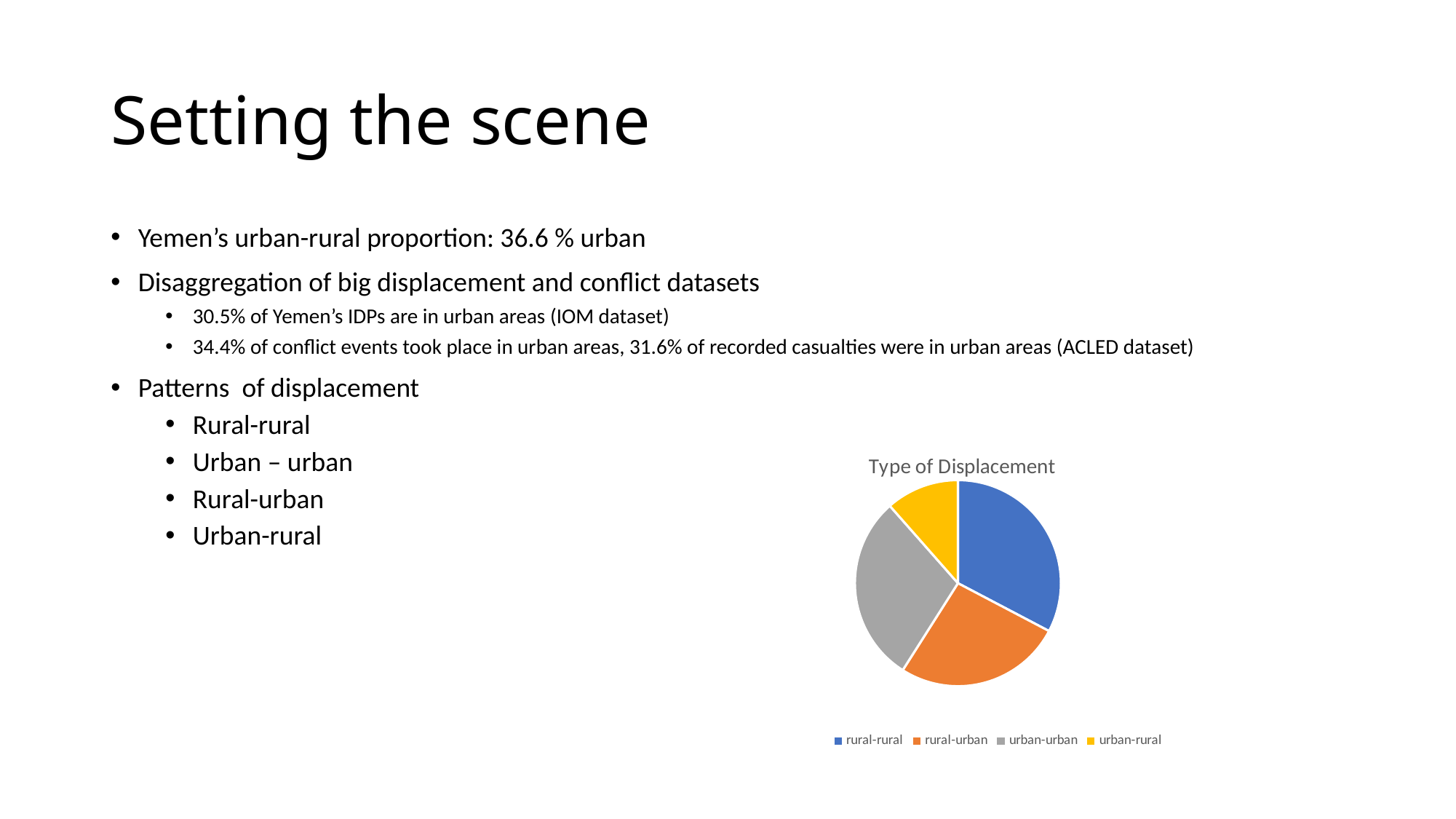
What colour is the urban-rural slice in the pie chart? yellow What is the title of the pie chart? Type of Displacement Which category has the smallest slice in the pie chart? urban-rural How many slices does the pie chart have? 4 How many entries does the legend of the pie chart list? 4 Which slice is larger in the pie chart, rural-urban or urban-rural? rural-urban Which slice is larger in the pie chart, urban-urban or urban-rural? urban-urban What kind of chart is shown on the slide? pie chart Which slice is larger in the pie chart, rural-rural or urban-rural? rural-rural